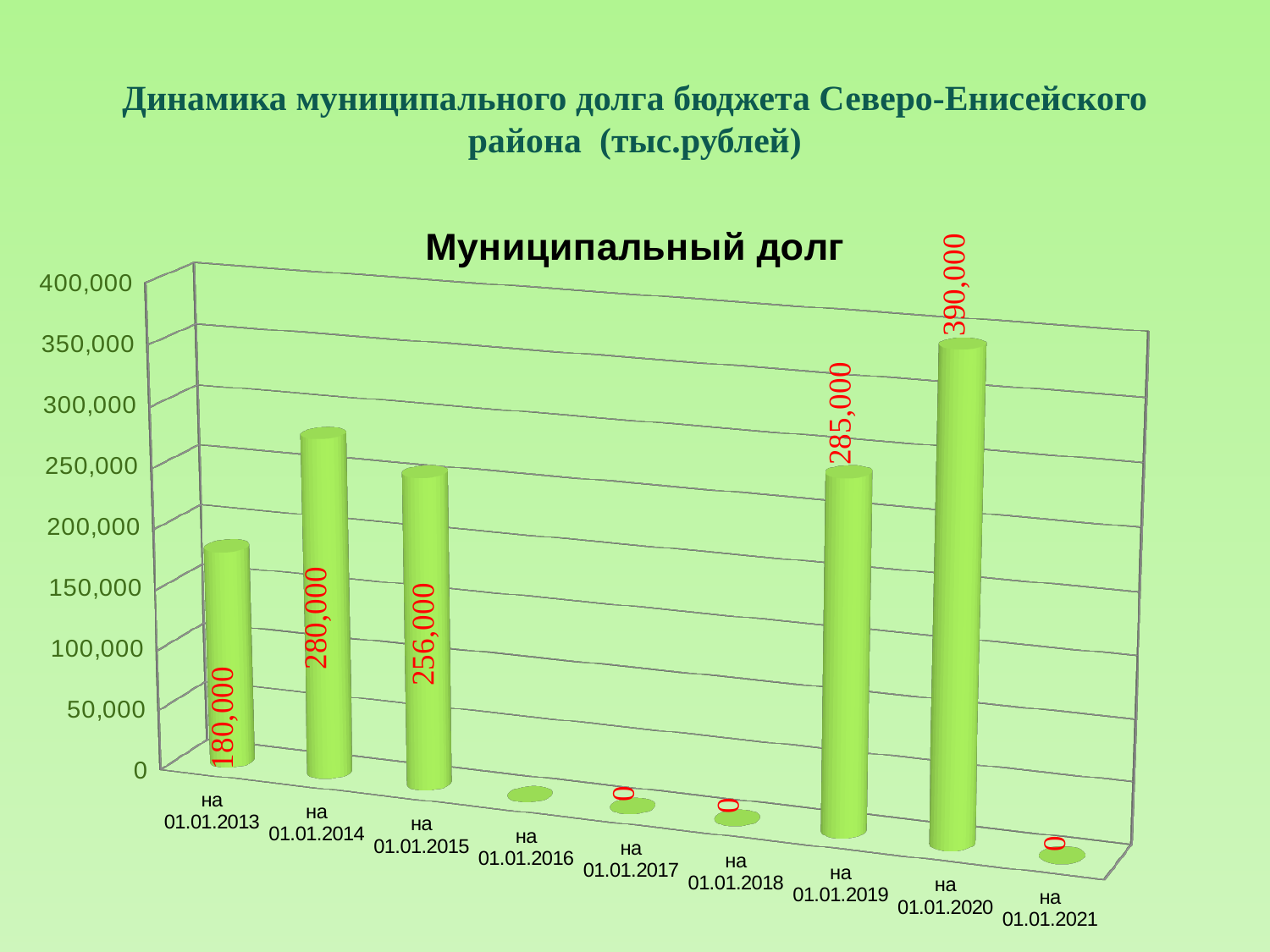
What kind of chart is shown on the slide? Bar chart Which is larger, the municipal debt on на 01.01.2014 or на 01.01.2015? на 01.01.2014 What is the difference between the municipal debt on на 01.01.2020 and на 01.01.2019? 105,000 Which date has the highest municipal debt? на 01.01.2020 How many dates (categories) are shown on the x axis? 9 What is the municipal debt value for на 01.01.2015? 256,000 What is the title of the chart? Муниципальный долг What is the municipal debt value for на 01.01.2020? 390,000 What is the municipal debt value for на 01.01.2013? 180,000 What is the municipal debt value for на 01.01.2017? 0 What is the municipal debt value for на 01.01.2014? 280,000 What is the difference between the municipal debt on на 01.01.2014 and на 01.01.2013? 100,000